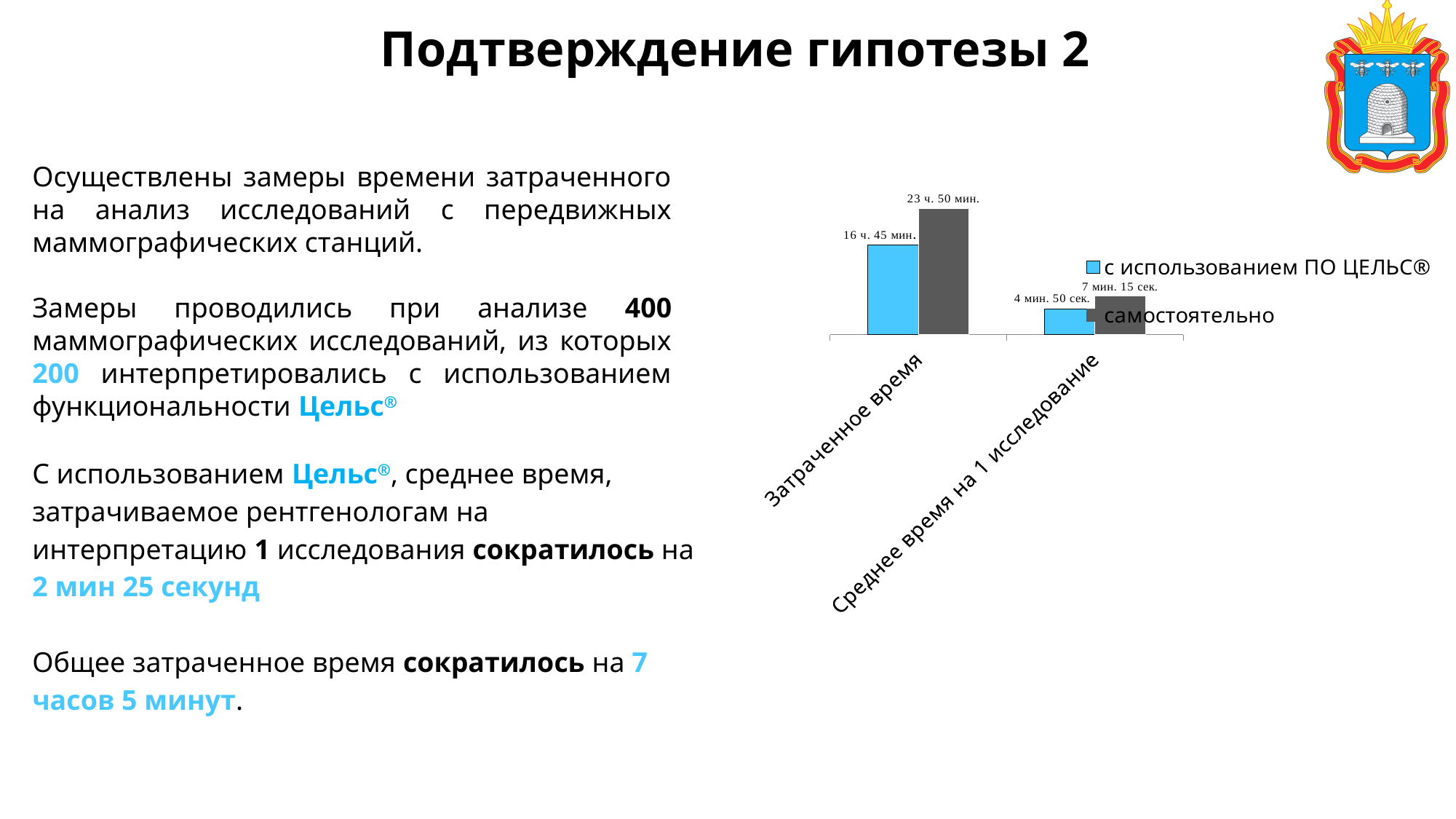
For "Затраченное время", which series has the larger value: "с использованием ПО ЦЕЛЬС®" or "самостоятельно"? самостоятельно What is the value for "Затраченное время" in the series "самостоятельно"? 23 ч. 50 мин. What is the difference between the "самостоятельно" and "с использованием ПО ЦЕЛЬС®" values for "Затраченное время"? 7 ч. 5 мин. What is the value for "Среднее время на 1 исследование" in the series "с использованием ПО ЦЕЛЬС®"? 4 мин. 50 сек. Which colour represents the series "с использованием ПО ЦЕЛЬС®" in the chart? blue What is the value for "Среднее время на 1 исследование" in the series "самостоятельно"? 7 мин. 15 сек. How many series does the chart legend list? 2 What kind of chart is shown on the slide? bar chart What is the value for "Затраченное время" in the series "с использованием ПО ЦЕЛЬС®"? 16 ч. 45 мин. How many categories are shown on the chart's x axis? 2 What is the difference between the "самостоятельно" and "с использованием ПО ЦЕЛЬС®" values for "Среднее время на 1 исследование"? 2 мин. 25 сек. For "Среднее время на 1 исследование", which series has the smaller value? с использованием ПО ЦЕЛЬС®